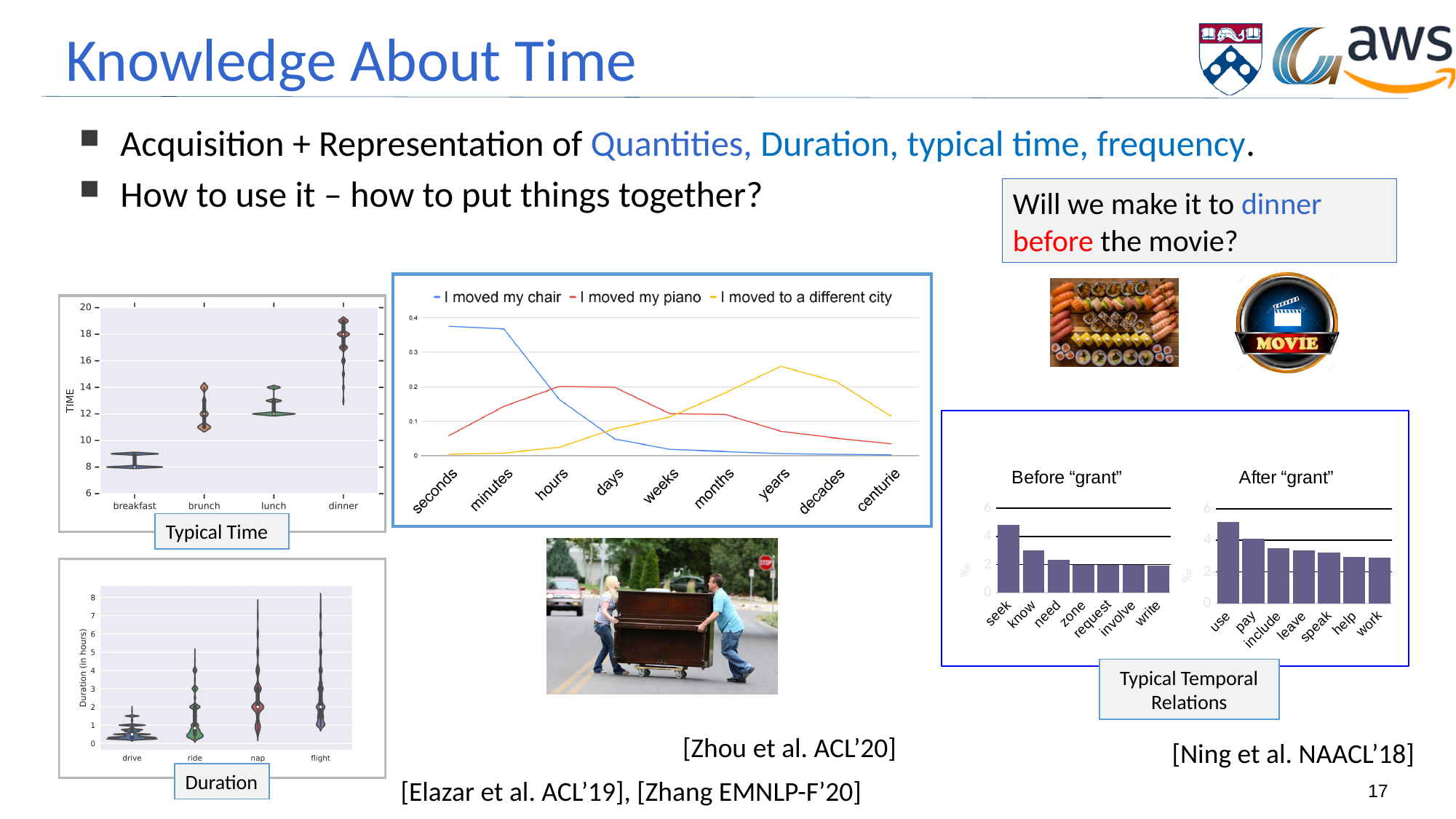
In the line chart with the legend 'I moved my chair', 'I moved my piano', 'I moved to a different city', does the 'I moved my chair' series rise or fall from 'minutes' to 'days'? fall In the line chart with the legend 'I moved my chair', 'I moved my piano', 'I moved to a different city', at which x-axis category does the 'I moved to a different city' series reach its highest value? years In the line chart with the legend 'I moved my chair', 'I moved my piano', 'I moved to a different city', how many categories are on the x axis? 9 In the line chart with the legend 'I moved my chair', 'I moved my piano', 'I moved to a different city', is the value for 'I moved my chair' at 'seconds' greater or less than 0.3? greater In the 'Before "grant"' chart, is the value for 'seek' greater or less than 4? greater In the line chart with the legend 'I moved my chair', 'I moved my piano', 'I moved to a different city', is the value for 'I moved my piano' at 'seconds' greater or less than 0.1? less In the 'Typical Time' chart, which category has the highest values on the TIME axis? dinner In the 'After "grant"' chart, which category has the highest value? use In the line chart with the legend 'I moved my chair', 'I moved my piano', 'I moved to a different city', how many series does the legend list? 3 In the 'Before "grant"' chart, how many bars are there? 7